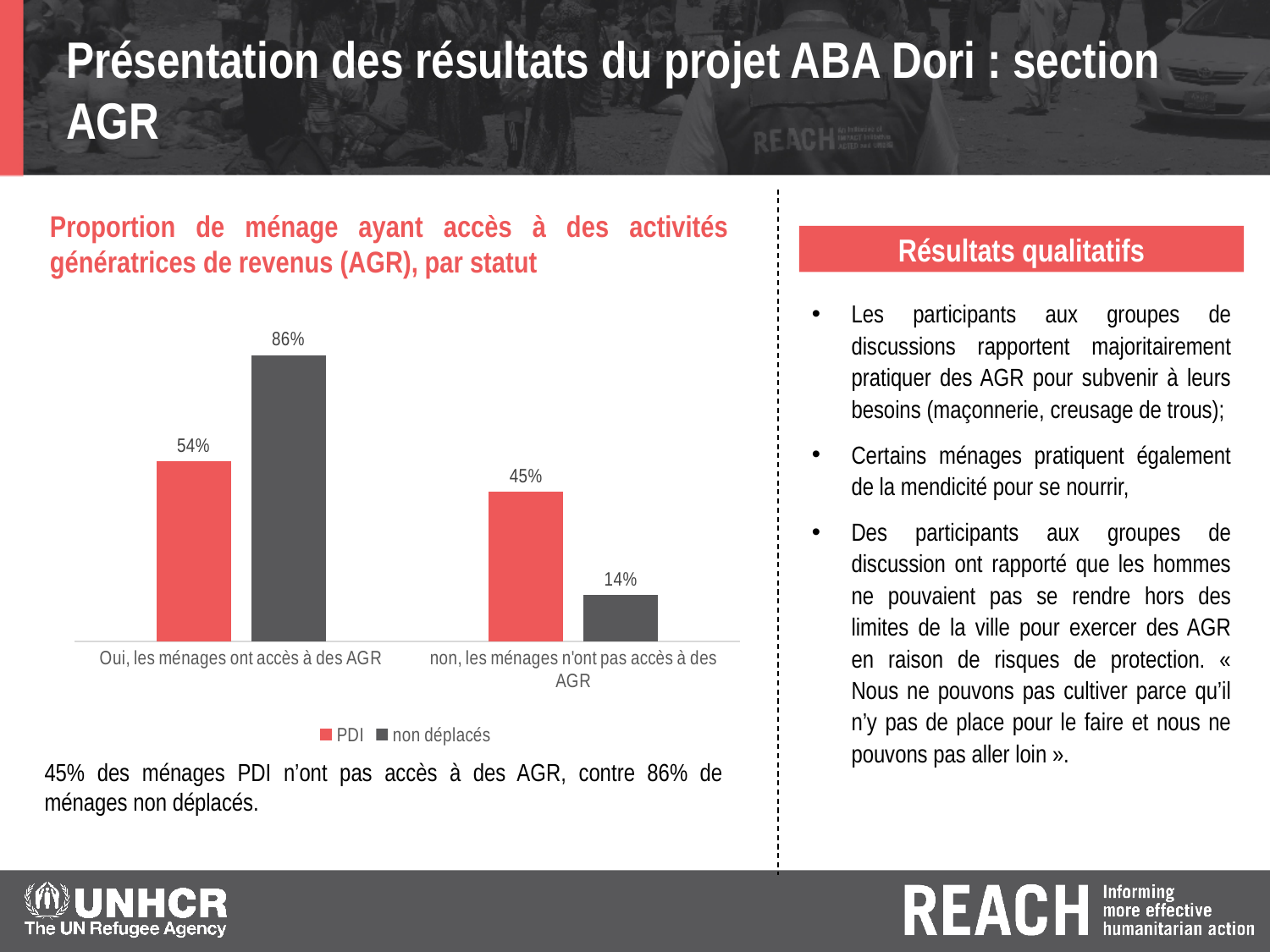
How many series does the chart legend list? 2 What is the value for PDI in the category "non, les ménages n'ont pas accès à des AGR"? 45% Which bar has the highest value in the chart? non déplacés, Oui, les ménages ont accès à des AGR What is the difference between the non déplacés and PDI values in the category "Oui, les ménages ont accès à des AGR"? 32% What is the value for PDI in the category "Oui, les ménages ont accès à des AGR"? 54% What is the difference between the PDI and non déplacés values in the category "non, les ménages n'ont pas accès à des AGR"? 31% How many categories are shown on the x axis of the chart? 2 Which bar has the lowest value in the chart? non déplacés, non, les ménages n'ont pas accès à des AGR In the category "Oui, les ménages ont accès à des AGR", which series has the larger value, PDI or non déplacés? non déplacés What is the value for non déplacés in the category "Oui, les ménages ont accès à des AGR"? 86% What is the value for non déplacés in the category "non, les ménages n'ont pas accès à des AGR"? 14% What kind of chart is shown on the slide? bar chart